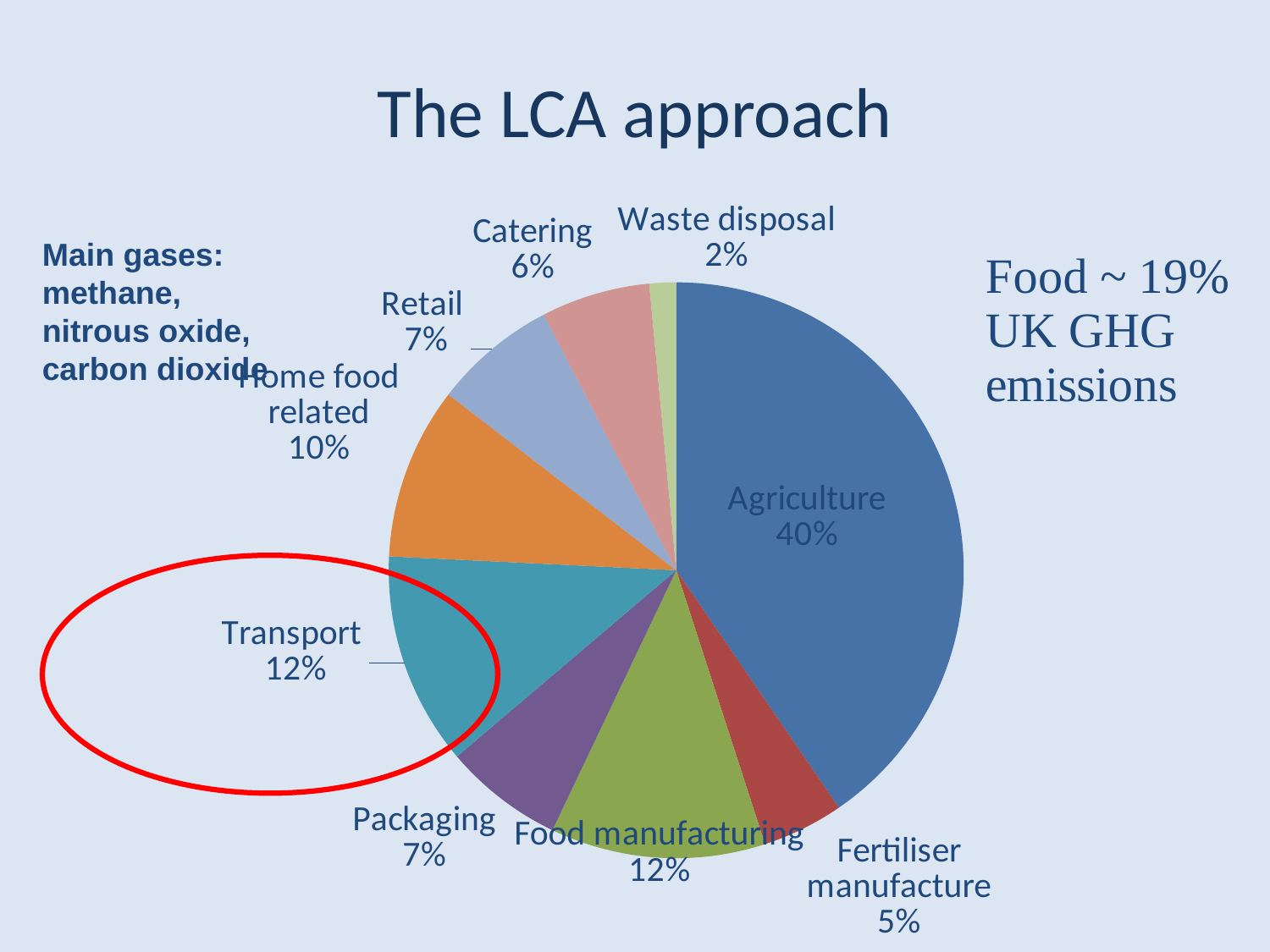
Which category has the largest slice of the pie? Agriculture Which slice of the pie chart is circled in red on the slide? Transport How many slices does the pie chart have? 9 What is the value shown for Fertiliser manufacture? 5% What is the difference between the Home food related share and the Packaging share? 3% Which category has the smallest slice of the pie? Waste disposal What is the value shown for Transport? 12% What is the value shown for Home food related? 10% What kind of chart is shown on the slide? Pie chart Which is larger, the share for Catering or the share for Retail? Retail What is the difference between the Agriculture share and the Food manufacturing share? 28% What share of the pie does Agriculture account for? 40%